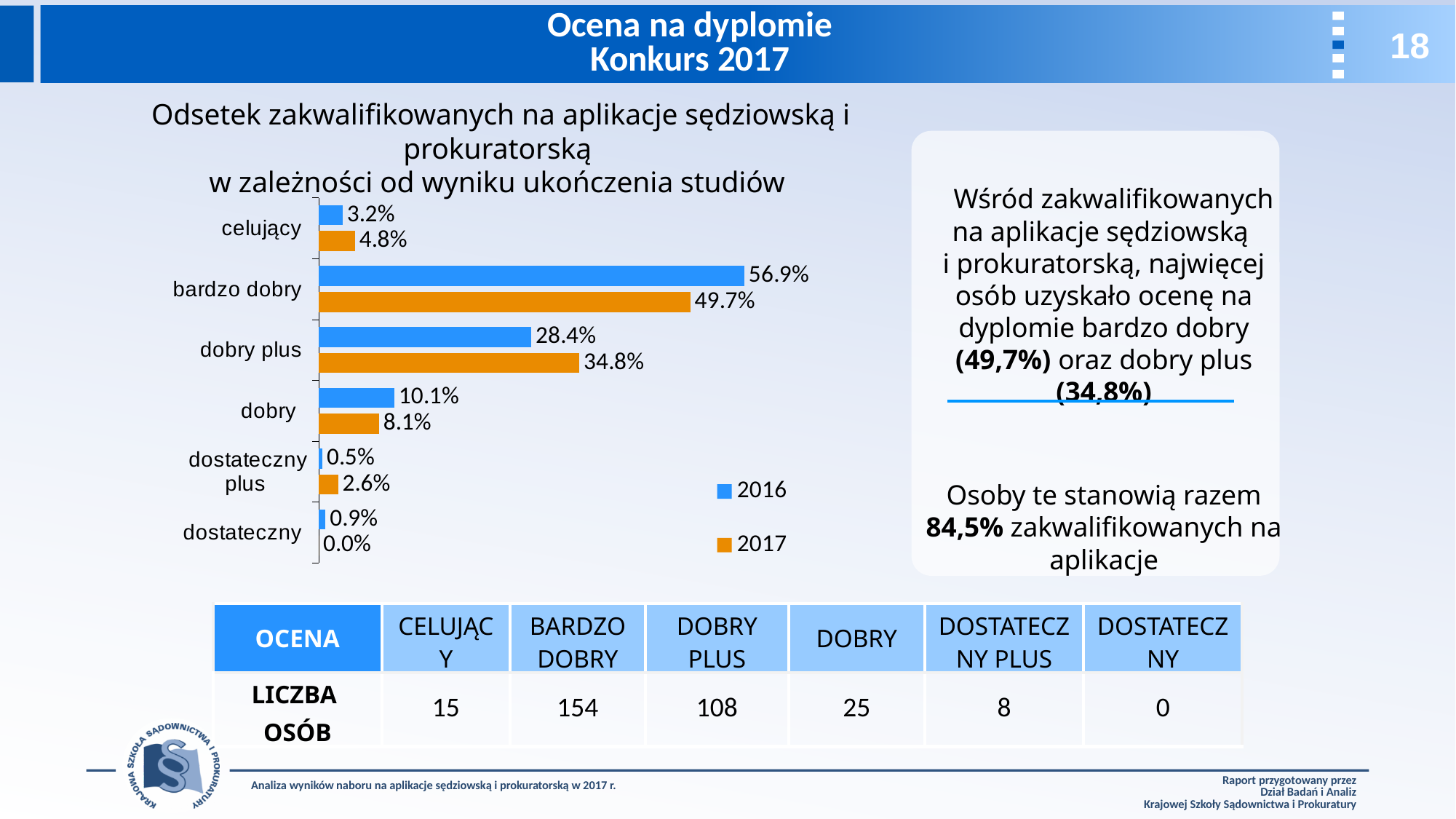
What is the 2016 value for celujący? 3.2% Which colour represents the 2017 series in the chart? orange Which category has the highest 2017 value? bardzo dobry What is the 2017 value for bardzo dobry? 49.7% What is the 2016 value for dobry plus? 28.4% Which category has the lowest 2016 value? dostateczny plus What is the difference between the 2016 and 2017 values for bardzo dobry? 7.2% What is the 2017 value for dostateczny? 0.0% How many categories are shown on the chart? 6 Which is larger for dobry plus: the 2016 value or the 2017 value? 2017 What kind of chart is shown on the slide? bar chart How many series does the legend list? 2